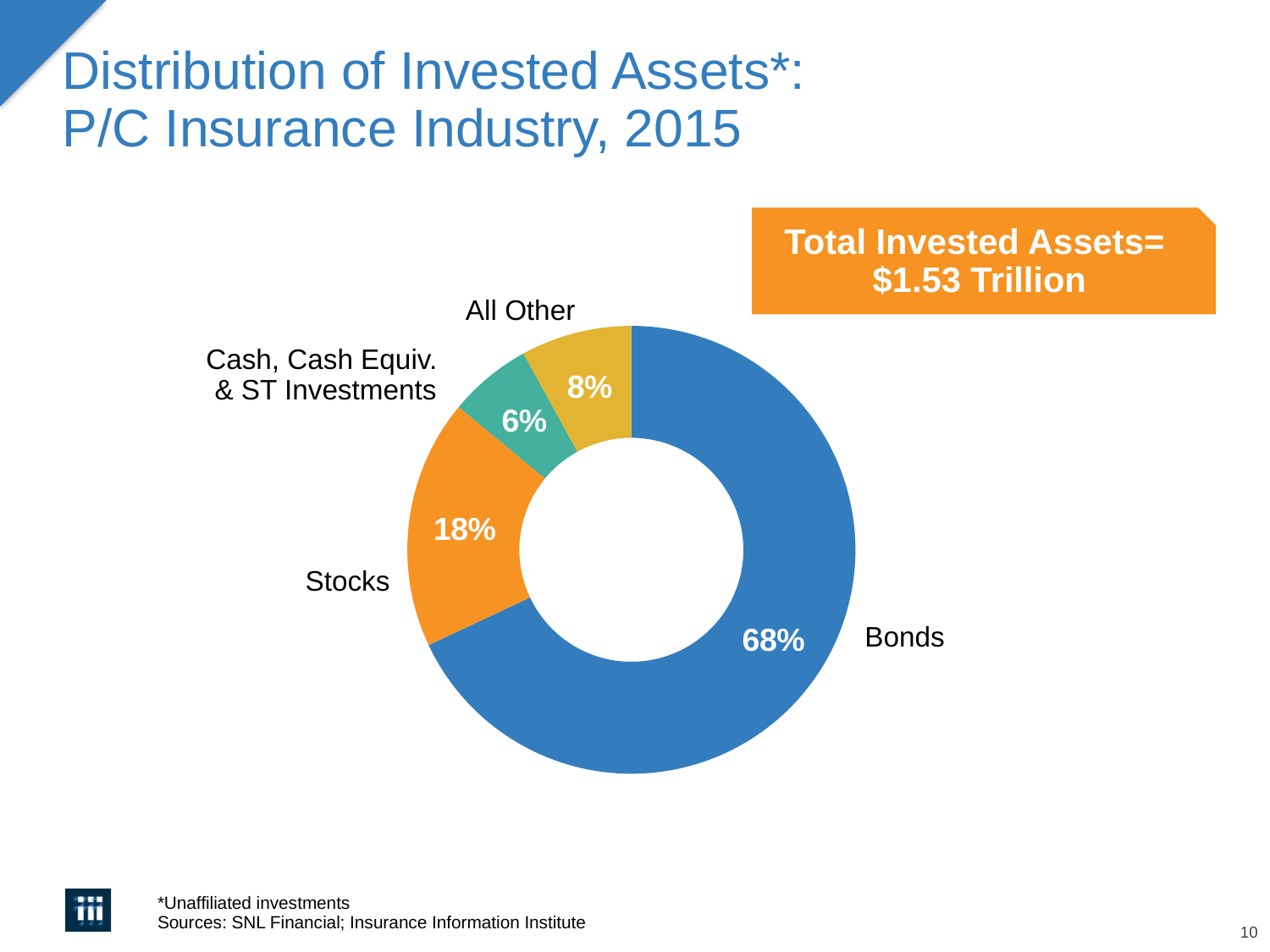
What share of invested assets is in Stocks? 18% What share of invested assets is in Cash, Cash Equiv. & ST Investments? 6% What is the difference in percentage points between the Bonds share and the Stocks share? 50 What share of invested assets is in All Other? 8% What is the total invested assets figure stated on the slide? $1.53 Trillion Which category has the smallest share of invested assets? Cash, Cash Equiv. & ST Investments What kind of chart is shown on the slide? Pie chart (doughnut) What colour is the Stocks slice? Orange Which has a larger share, All Other or Cash, Cash Equiv. & ST Investments? All Other How many categories are shown in the chart? 4 What share of invested assets is in Bonds? 68% Which category has the largest share of invested assets? Bonds